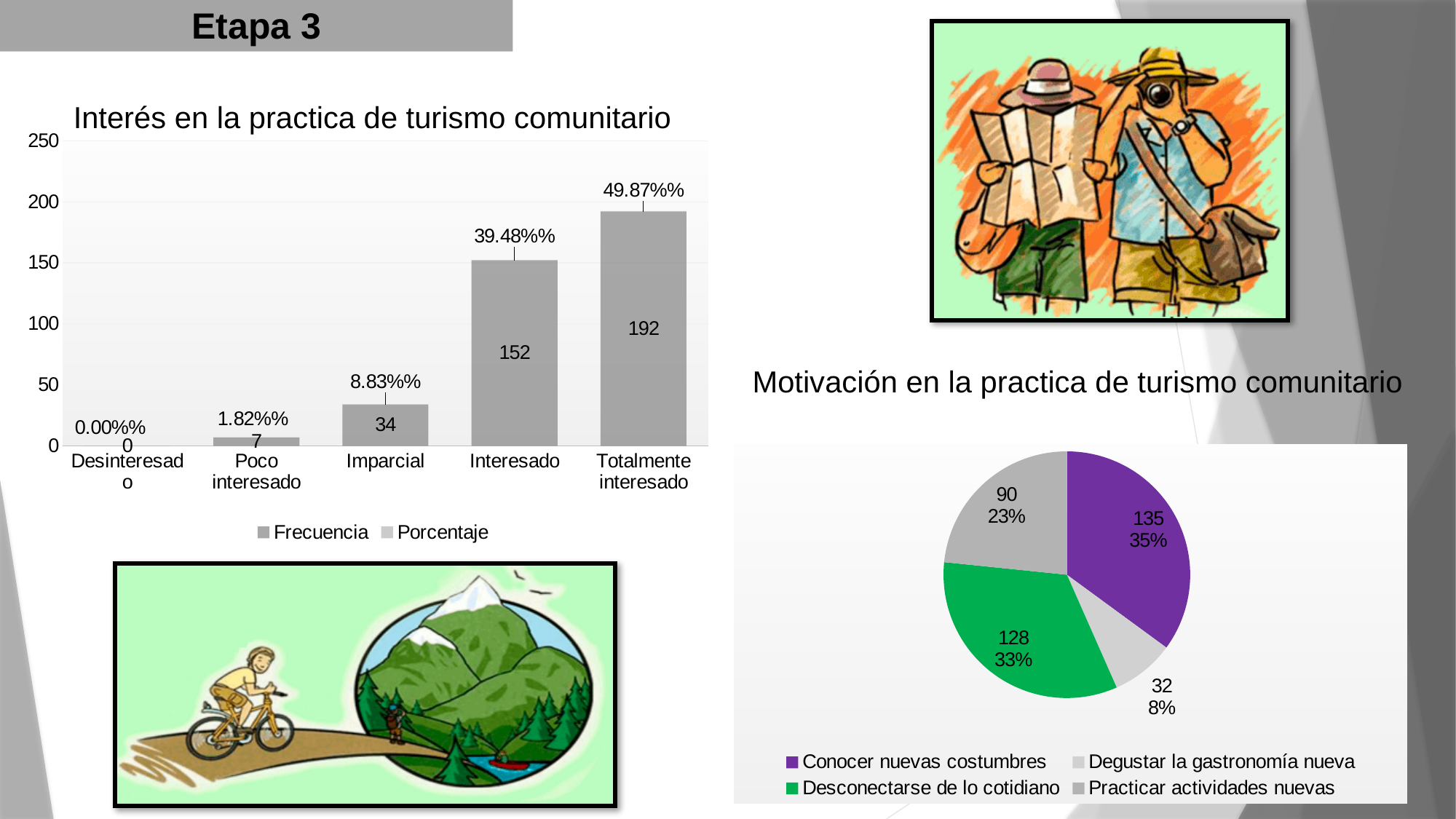
In the 'Interés en la practica de turismo comunitario' chart, which category has the lowest Frecuencia? Desinteresado In the 'Interés en la practica de turismo comunitario' chart, what is the difference in Frecuencia between Totalmente interesado and Interesado? 40 In the 'Interés en la practica de turismo comunitario' chart, which category has the highest Frecuencia? Totalmente interesado In the 'Motivación en la practica de turismo comunitario' pie chart, what share does Desconectarse de lo cotidiano have? 33% In the 'Motivación en la practica de turismo comunitario' pie chart, which slice is the smallest? Degustar la gastronomía nueva In the 'Interés en la practica de turismo comunitario' chart, do the Frecuencia values rise or fall from left to right along the x axis? Rise In the 'Interés en la practica de turismo comunitario' chart, how many categories are shown on the x axis? 5 In the 'Motivación en la practica de turismo comunitario' pie chart, what is the value for Practicar actividades nuevas? 90 In the 'Interés en la practica de turismo comunitario' chart, what is the Frecuencia value for Imparcial? 34 In the 'Interés en la practica de turismo comunitario' chart, how many series does the legend list? 2 In the 'Interés en la practica de turismo comunitario' chart, what is the Frecuencia value for Interesado? 152 What kind of chart is 'Interés en la practica de turismo comunitario'? Bar chart